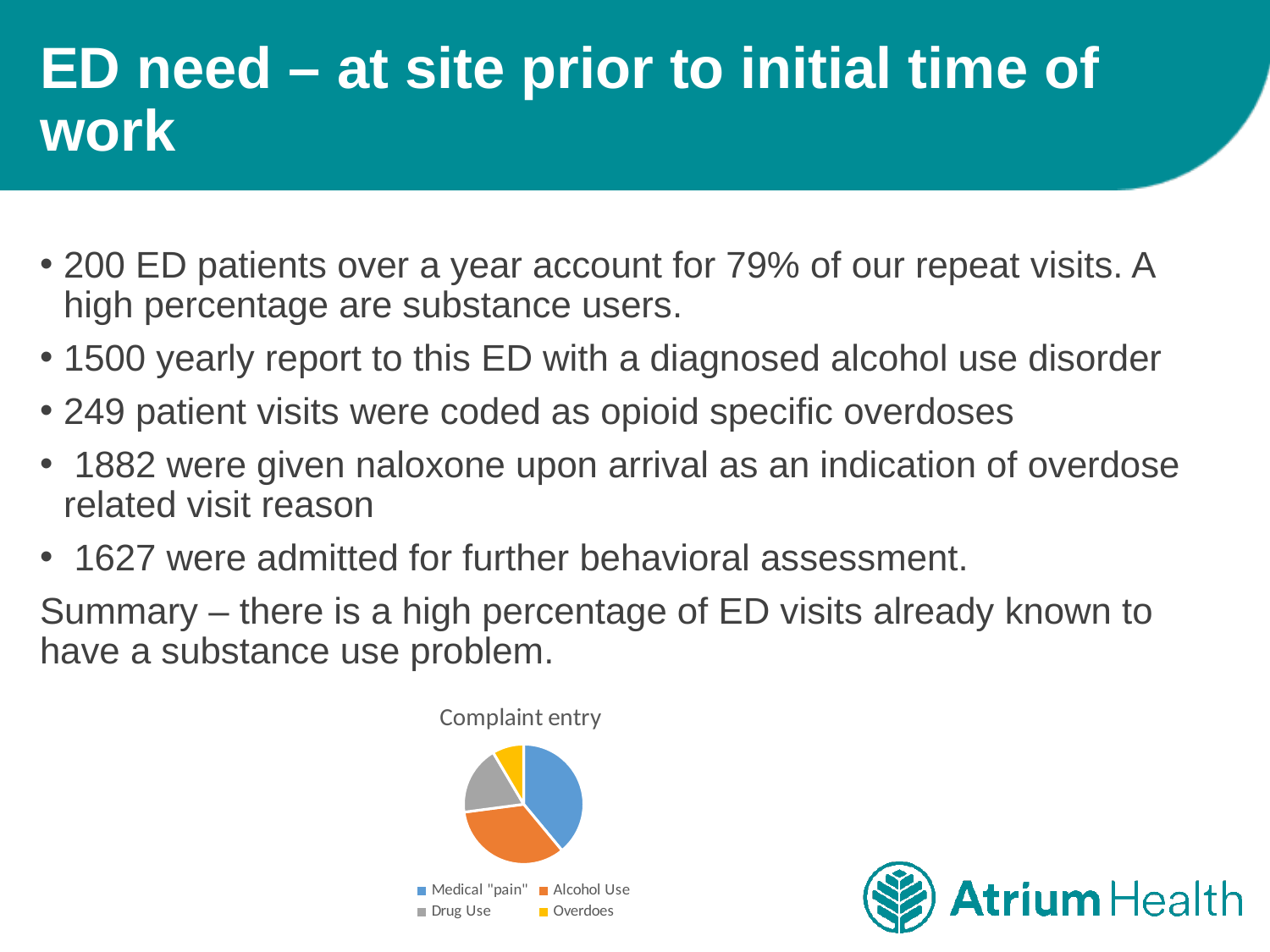
In the Complaint entry pie chart, which slice is larger: Alcohol Use or Overdoes? Alcohol Use In the Complaint entry pie chart, which slice is larger: Medical "pain" or Drug Use? Medical "pain" In the Complaint entry pie chart, which slice is larger: Medical "pain" or Alcohol Use? Medical "pain" Which category has the largest slice in the Complaint entry pie chart? Medical "pain" Which category has the smallest slice in the Complaint entry pie chart? Overdoes What colour represents Drug Use in the Complaint entry pie chart? Gray How many slices does the Complaint entry pie chart have? 4 What is the title of the chart on the slide? Complaint entry How many entries does the legend of the Complaint entry chart list? 4 What kind of chart is shown on the slide? Pie chart